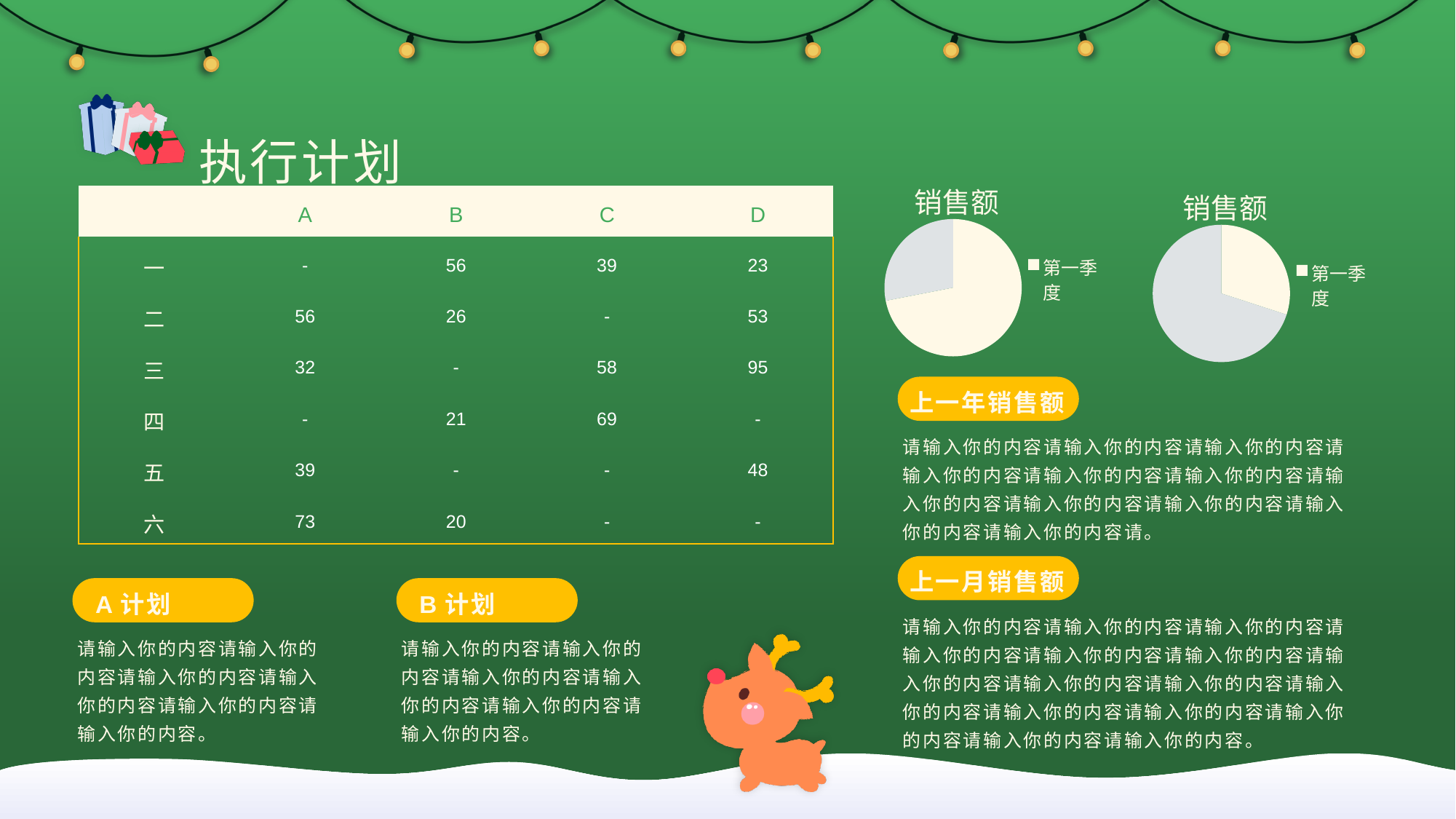
What kind of chart is the left chart titled 销售额? pie chart In the left 销售额 pie chart, is the cream-coloured slice larger or smaller than the grey slice? larger In the right 销售额 pie chart, is the grey slice larger or smaller than the cream-coloured slice? larger How many slices does the right 销售额 pie chart have? 2 How many slices does the left 销售额 pie chart have? 2 What is the title of the right pie chart on the slide? 销售额 How many series does the legend of the right 销售额 chart list? 1 What is the legend entry shown next to the left 销售额 pie chart? 第一季度 What kind of chart is the right chart titled 销售额? pie chart How many series does the legend of the left 销售额 chart list? 1